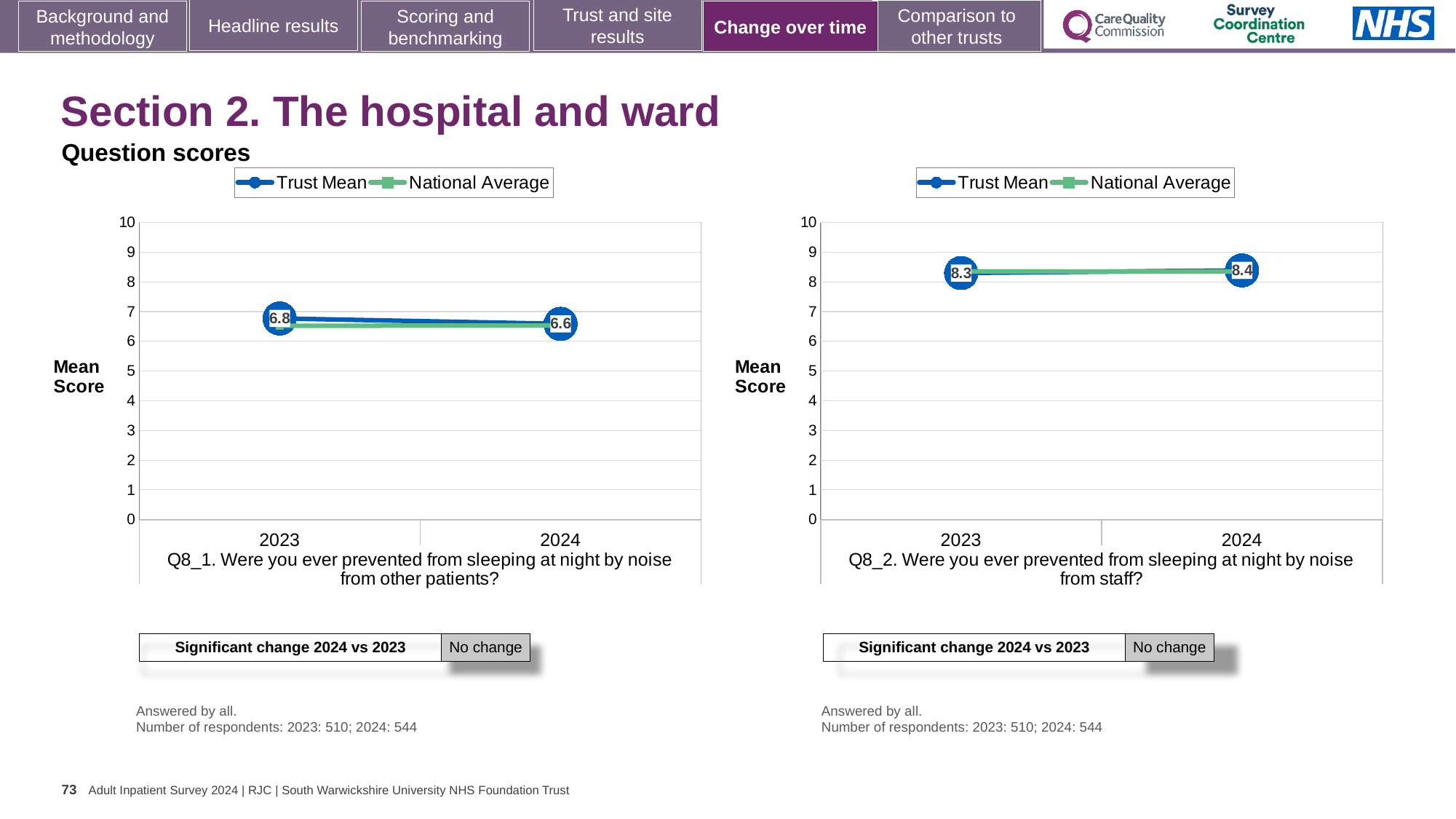
What type of chart is used for Q8_1 (left)? line chart In the Q8_2 chart (right), what is the Trust Mean score for 2023? 8.3 In the Q8_1 chart (left), what is the Trust Mean score for 2024? 6.6 In the Q8_1 chart (left), is the National Average for 2024 greater or less than 8? less In the Q8_1 chart (left), does the Trust Mean rise or fall from 2023 to 2024? fall In the Q8_1 chart (left), what is the Trust Mean score for 2023? 6.8 In the Q8_2 chart (right), what is the Trust Mean score for 2024? 8.4 In the Q8_2 chart (right), does the Trust Mean rise or fall from 2023 to 2024? rise In the Q8_1 chart (left), by how much did the Trust Mean change from 2023 to 2024? 0.2 In the Q8_2 chart (right), what is the difference between the Trust Mean for 2024 and 2023? 0.1 What does the 'Significant change 2024 vs 2023' box below the Q8_2 chart (right) say? No change How many series does the legend of the Q8_2 chart (right) list? 2